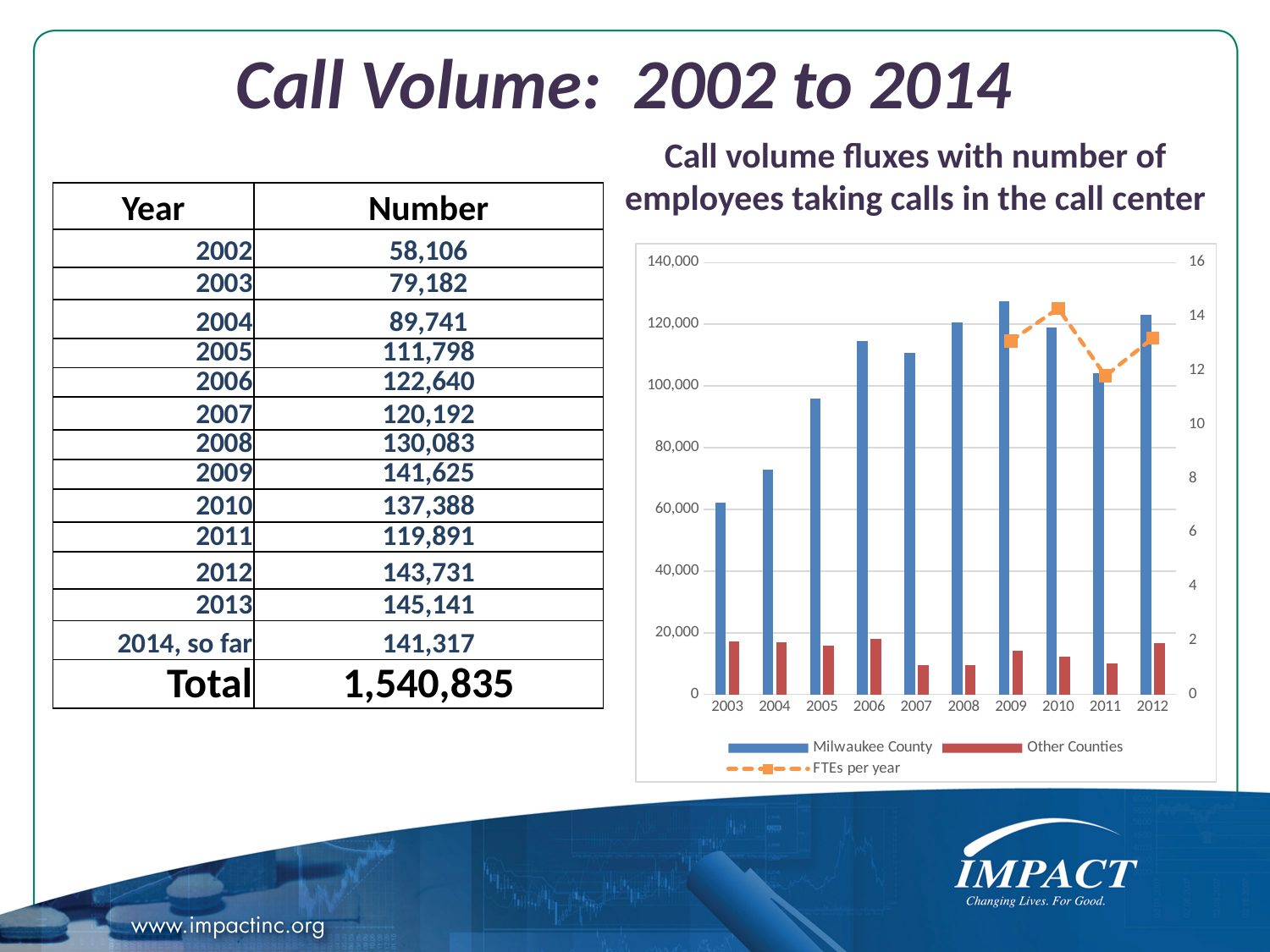
Which is larger, the Milwaukee County value for 2011 or for 2012? 2012 How many series does the chart legend list? 3 Is the Milwaukee County value for 2003 greater or less than 80,000? less In which year is the FTEs per year line at its highest point? 2010 In which year is the Milwaukee County bar highest? 2009 Which is larger, the Milwaukee County value for 2006 or for 2007? 2006 Is the Milwaukee County value for 2009 greater or less than 120,000? greater In which year is the Milwaukee County bar lowest? 2003 What is the title shown above the chart? Call volume fluxes with number of employees taking calls in the call center Do the Milwaukee County values rise or fall from 2003 to 2006? rise What kind of chart is shown on the slide? bar chart (with a dashed line series) How many years are shown on the x axis of the chart? 10